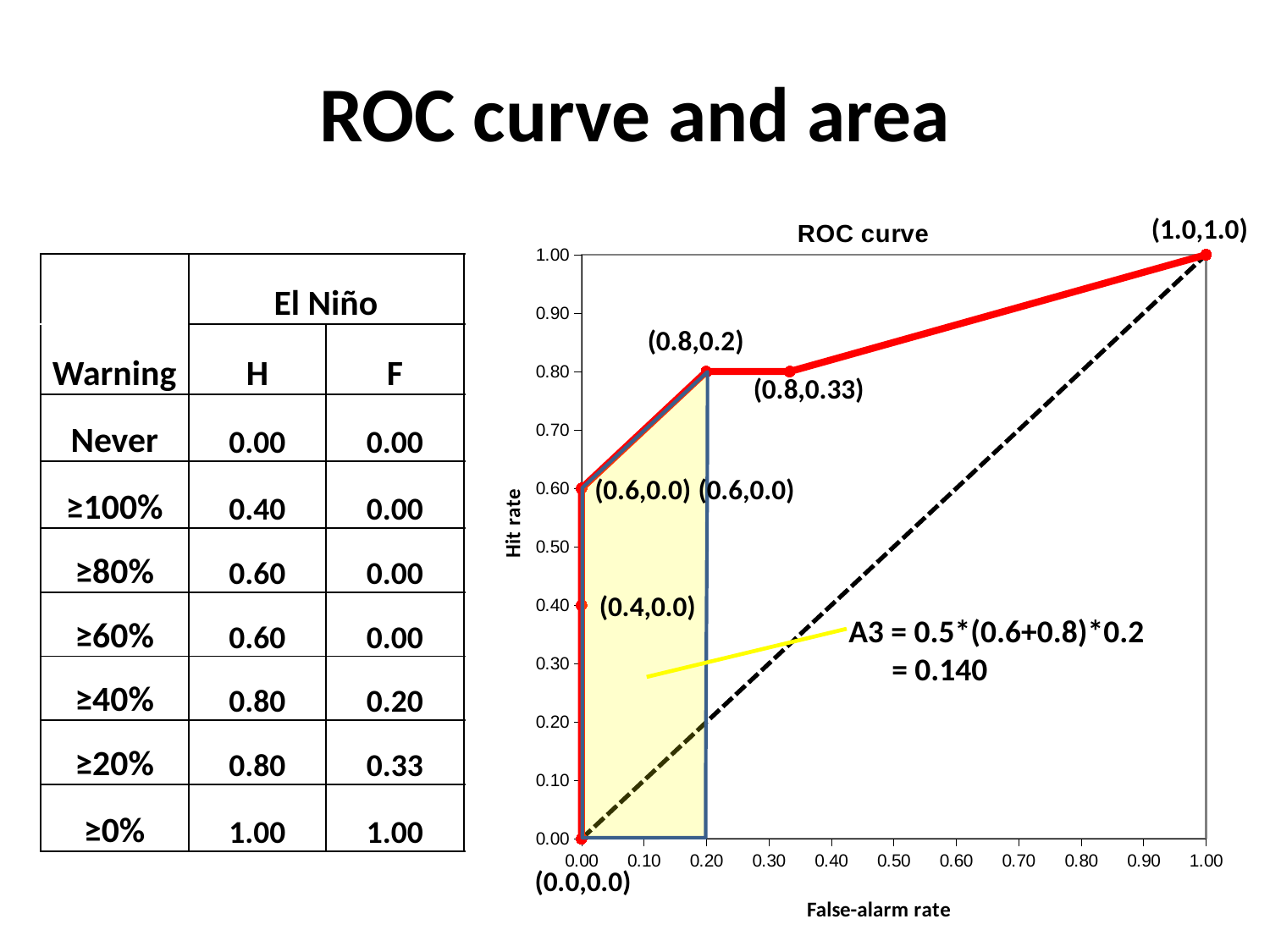
What is the largest tick value shown on the x axis of the chart? 1.00 According to the labeled point on the chart, what is the hit rate when the false-alarm rate is 0.2? 0.8 What is the title of the chart? ROC curve Is the hit rate at the point labeled (0.8,0.2) greater or less than 0.50? greater According to the labeled point on the chart, what is the hit rate when the false-alarm rate is 0.33? 0.8 What is the label of the x axis of the chart? False-alarm rate What is the value of A3 given in the annotation on the chart? 0.140 What kind of chart is shown on the slide? line chart Which is larger: the hit rate at the point labeled (0.4,0.0) or at the point labeled (0.8,0.2)? (0.8,0.2) Does the hit rate of the ROC curve rise or fall as the false-alarm rate increases? rise What is the highest hit rate reached by the ROC curve? 1.0 What is the difference in hit rate between the point labeled (1.0,1.0) and the point labeled (0.8,0.33)? 0.2